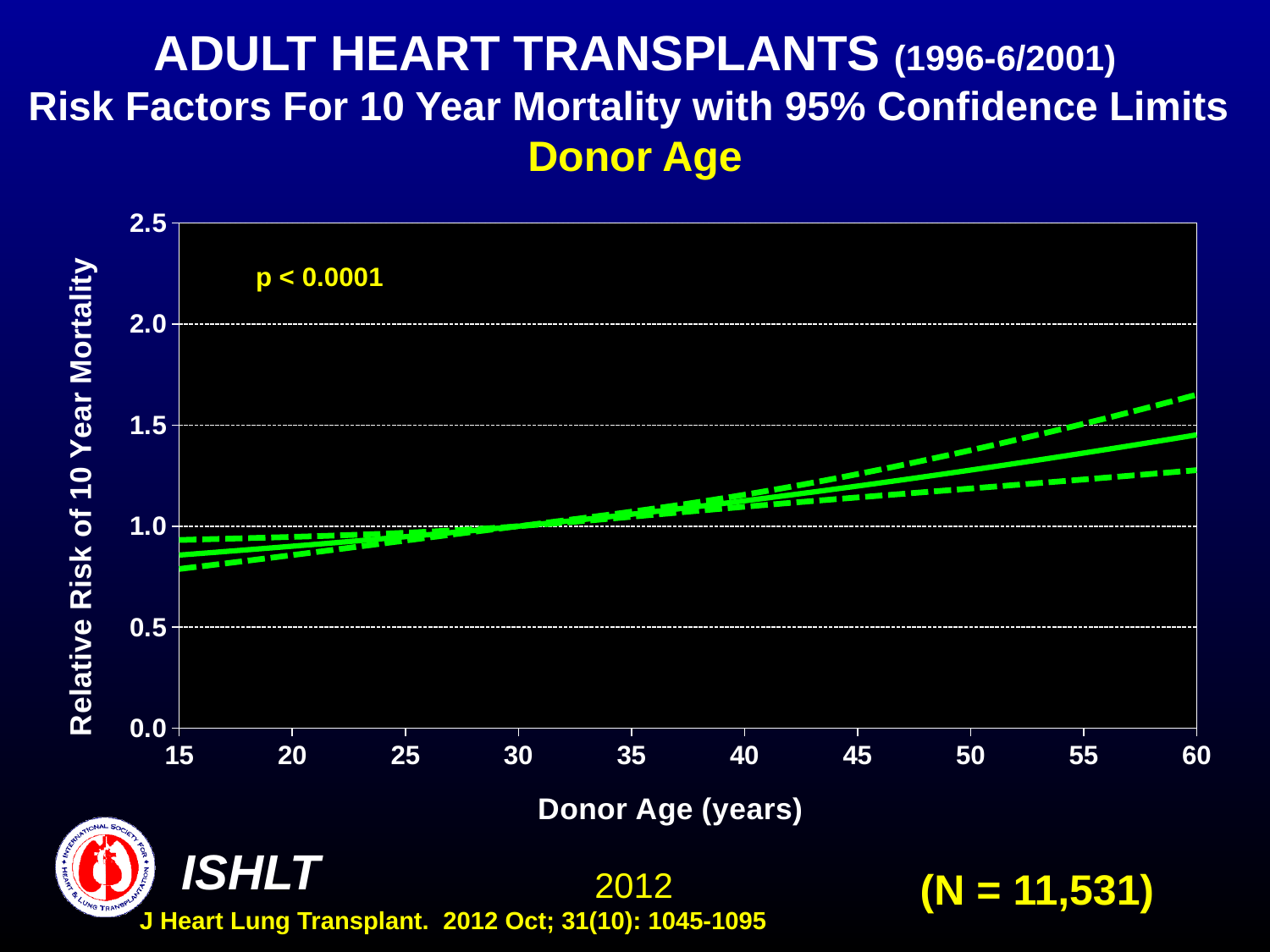
Is the relative risk shown by the solid line at donor age 60 greater or less than 1.0? greater What kind of chart is shown on the slide? line chart Is the upper dashed confidence limit at donor age 60 greater or less than 1.5? greater What is the label of the x axis? Donor Age (years) What is the p-value printed on the chart? p < 0.0001 Is the relative risk shown by the solid line at donor age 15 greater or less than 1.0? less Does the relative risk of 10 year mortality rise or fall as donor age increases from 15 to 60 years? rise How many lines are plotted on the chart? 3